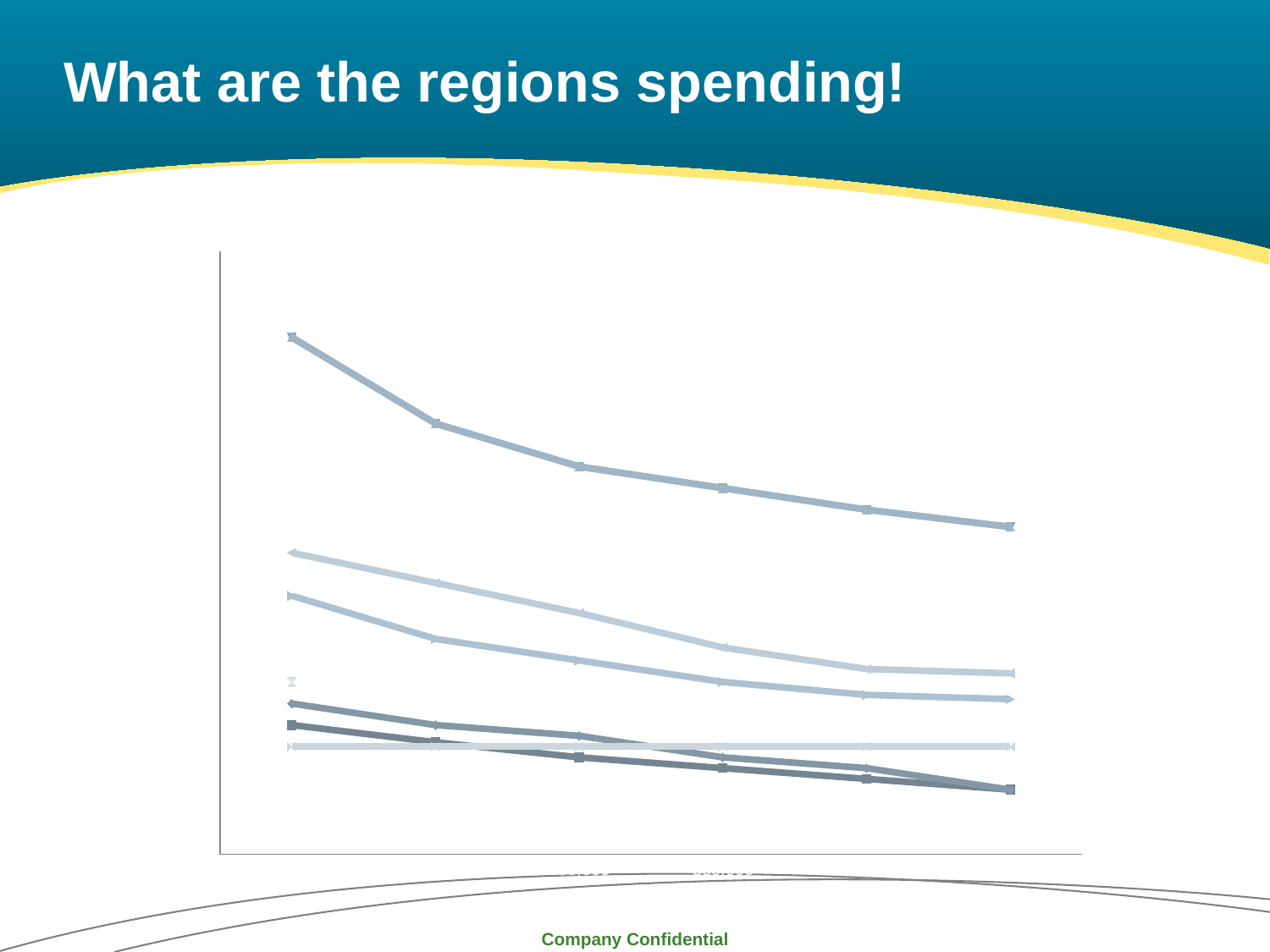
What kind of chart is shown on the slide? line chart How many data points does the topmost line have along the x axis? 6 Do the values of the topmost line rise or fall from left to right along the x axis? fall Do most of the lines on the chart trend upward or downward from left to right? downward Does the lowest, lightest line rise, fall, or stay flat across the x axis? stay flat